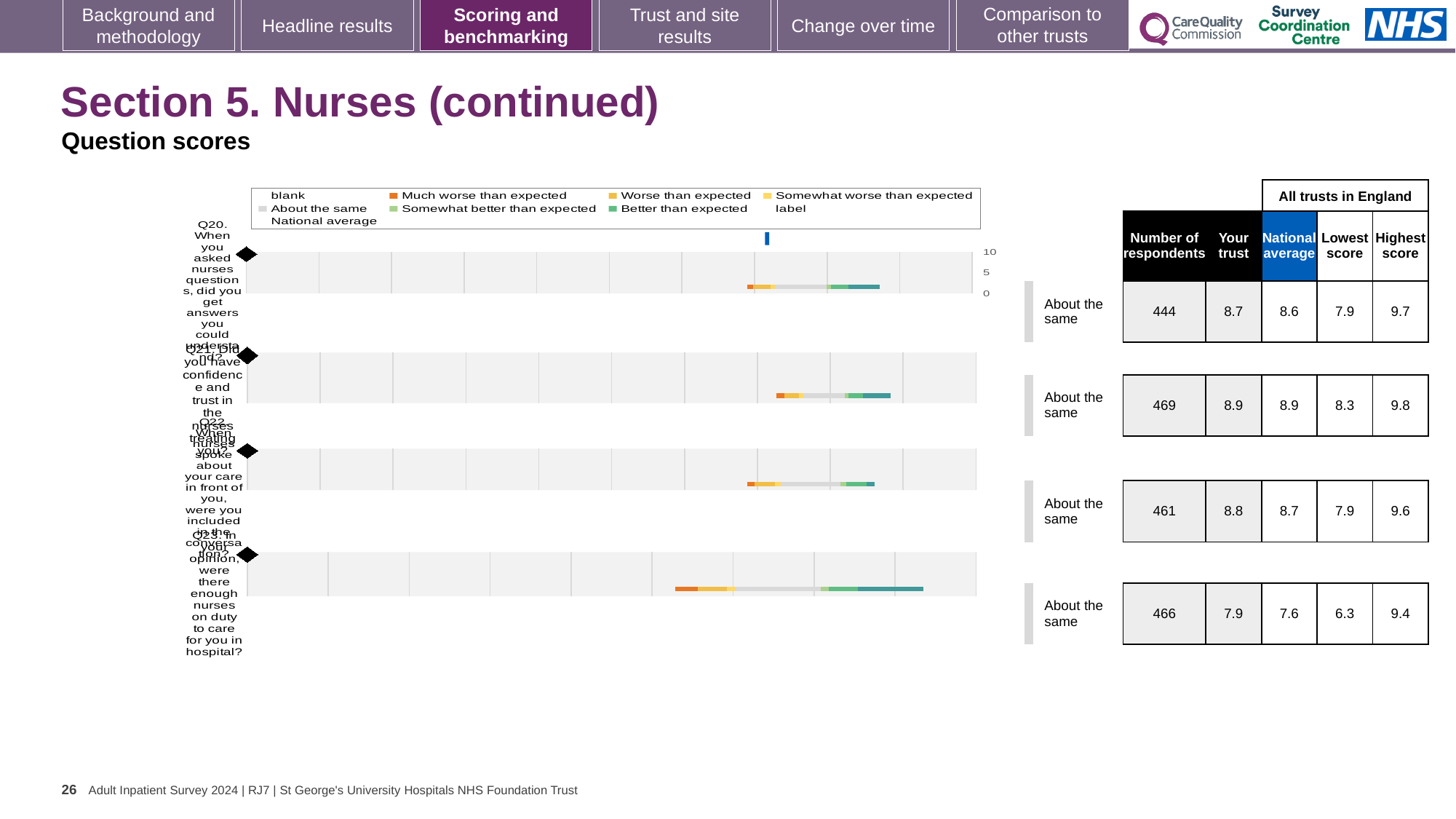
What benchmark category is shown for Q22? About the same How many questions (categories) are plotted in the chart? 4 What is the difference between the 'Your trust' score and the national average for Q23? 0.3 How many entries does the chart legend list? 9 What kind of chart is used to show the question scores on this slide? bar chart Which question has the highest 'Your trust' score? Q21 How many respondents answered Q20 (answers you could understand)? 444 For Q20, which is larger: the 'Your trust' score or the national average? Your trust Which question has the lowest 'Your trust' score? Q23 What is the 'Your trust' score for Q21 (confidence and trust in the nurses)? 8.9 What is the highest score across all trusts in England for Q22 (included in the conversation)? 9.6 What is the national average score for Q23 (enough nurses on duty)? 7.6